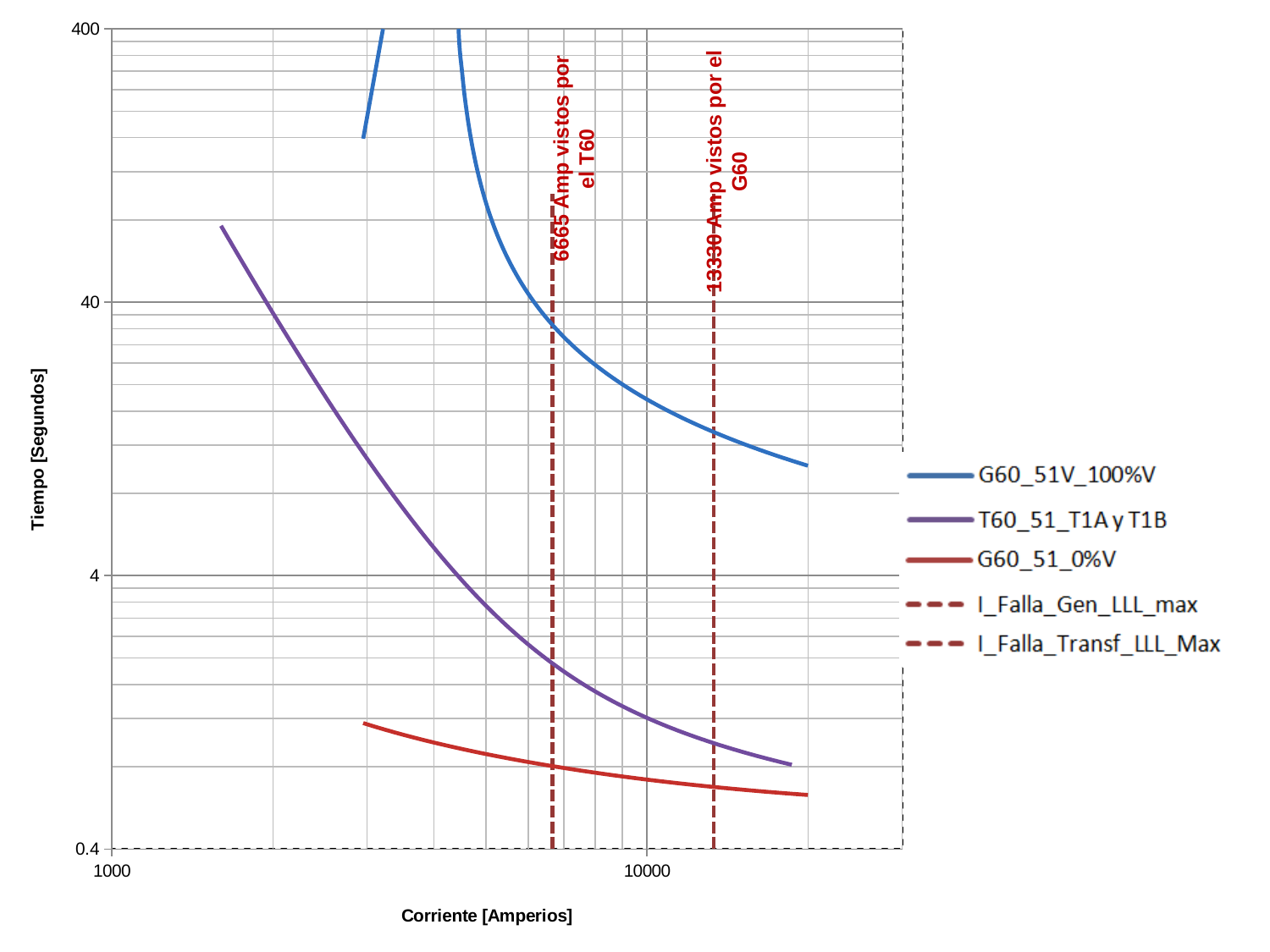
At 10000 amperes, which curve has the higher time value, G60_51V_100%V or T60_51_T1A y T1B? G60_51V_100%V What current value is written on the annotation for the amps seen by the T60? 6665 Amp How many series does the legend list? 5 Which curve lies lowest on the chart across the plotted current range? G60_51_0%V Do the time values of the T60_51_T1A y T1B curve rise or fall as current increases? fall Is the time value of the T60_51_T1A y T1B curve at 10000 amperes greater or less than 4? less What kind of chart is shown on the slide? line chart What current value is written on the annotation for the amps seen by the G60? 13330 Amp What is the title of the vertical axis? Tiempo [Segundos] Is the time value of the G60_51V_100%V curve at 10000 amperes greater or less than 40? less What is the title of the horizontal axis? Corriente [Amperios] Is the time value of the G60_51_0%V curve at 10000 amperes greater or less than 4? less